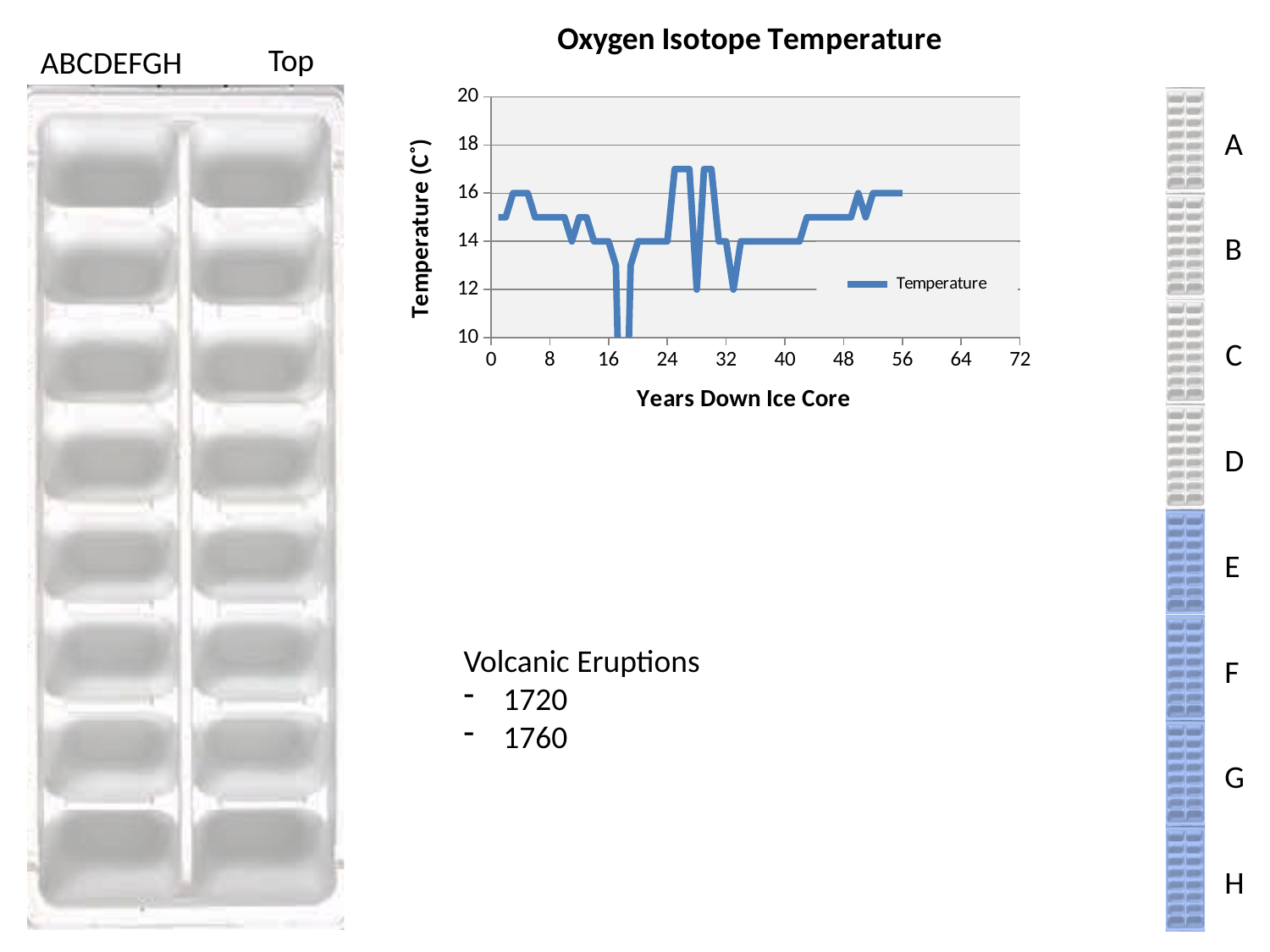
In the Oxygen Isotope Temperature chart, what is the temperature at 56 years down the ice core, the last point of the line? 16 In the Oxygen Isotope Temperature chart, is the temperature at 25 years down the ice core greater or less than 16? greater What is the title of the chart on the slide? Oxygen Isotope Temperature In the Oxygen Isotope Temperature chart, which is higher: the temperature at 25 years down the ice core or at 40 years down the ice core? 25 years What is the legend entry shown on the Oxygen Isotope Temperature chart? Temperature In the Oxygen Isotope Temperature chart, is the temperature at 40 years down the ice core greater or less than 16? less In the Oxygen Isotope Temperature chart, is the temperature at 4 years down the ice core greater or less than 14? greater What kind of chart is the Oxygen Isotope Temperature chart? line chart How many series does the legend of the Oxygen Isotope Temperature chart list? 1 In the Oxygen Isotope Temperature chart, what is the temperature at 22 years down the ice core? 14